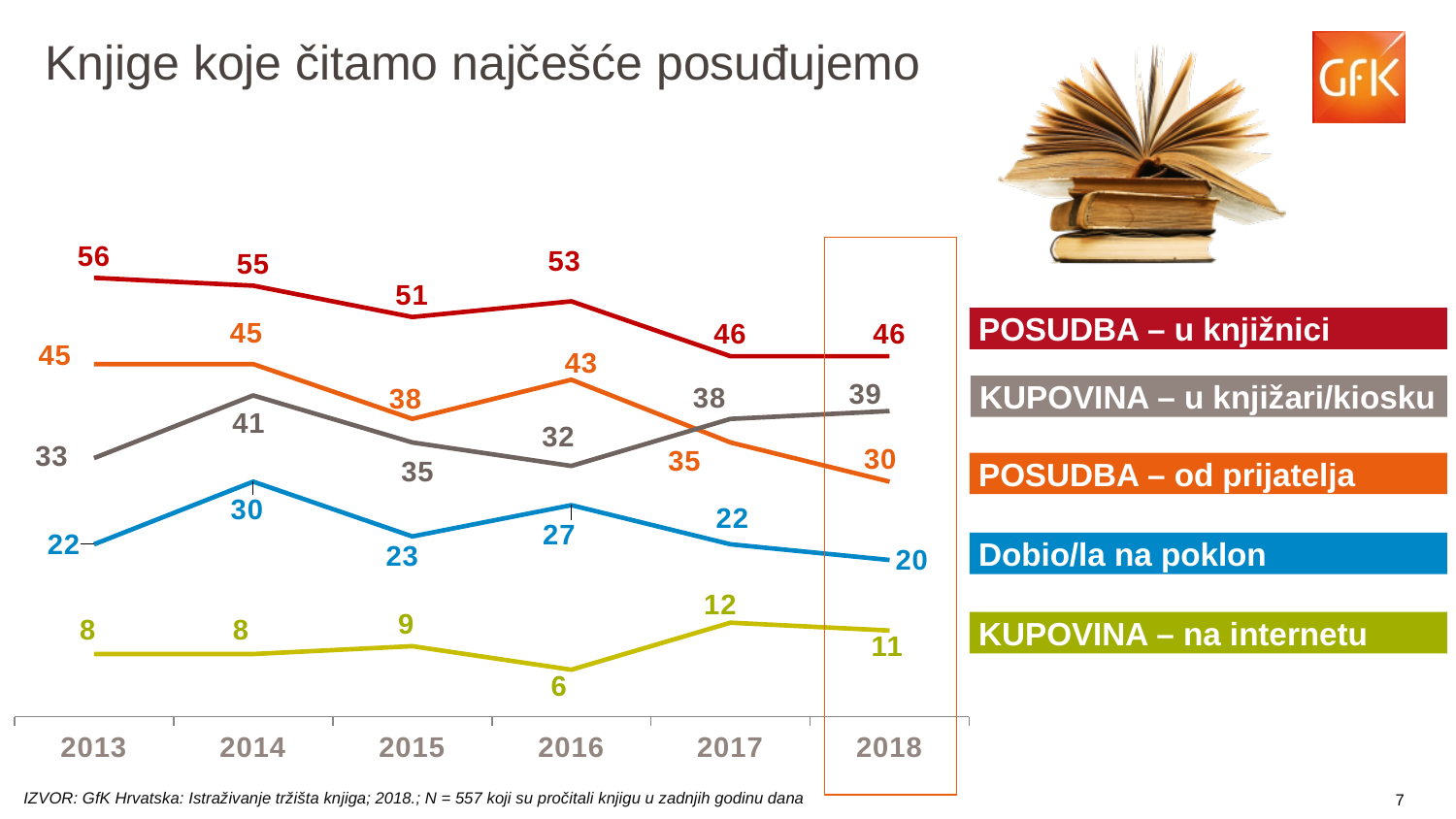
How many series does the legend list? 5 How many years are shown on the x axis? 6 Which is larger in 2017: KUPOVINA – u knjižari/kiosku or POSUDBA – od prijatelja? KUPOVINA – u knjižari/kiosku In which year is KUPOVINA – na internetu lowest? 2016 What is the difference between POSUDBA – u knjižnici in 2013 and in 2018? 10 What kind of chart is shown on the slide? line chart What is the value for Dobio/la na poklon in 2014? 30 What is the value for KUPOVINA – u knjižari/kiosku in 2018? 39 Which series is shown in red? POSUDBA – u knjižnici In which year is POSUDBA – od prijatelja highest? 2013 and 2014 Does the value for POSUDBA – od prijatelja rise or fall from 2016 to 2018? fall What is the value for POSUDBA – u knjižnici in 2013? 56